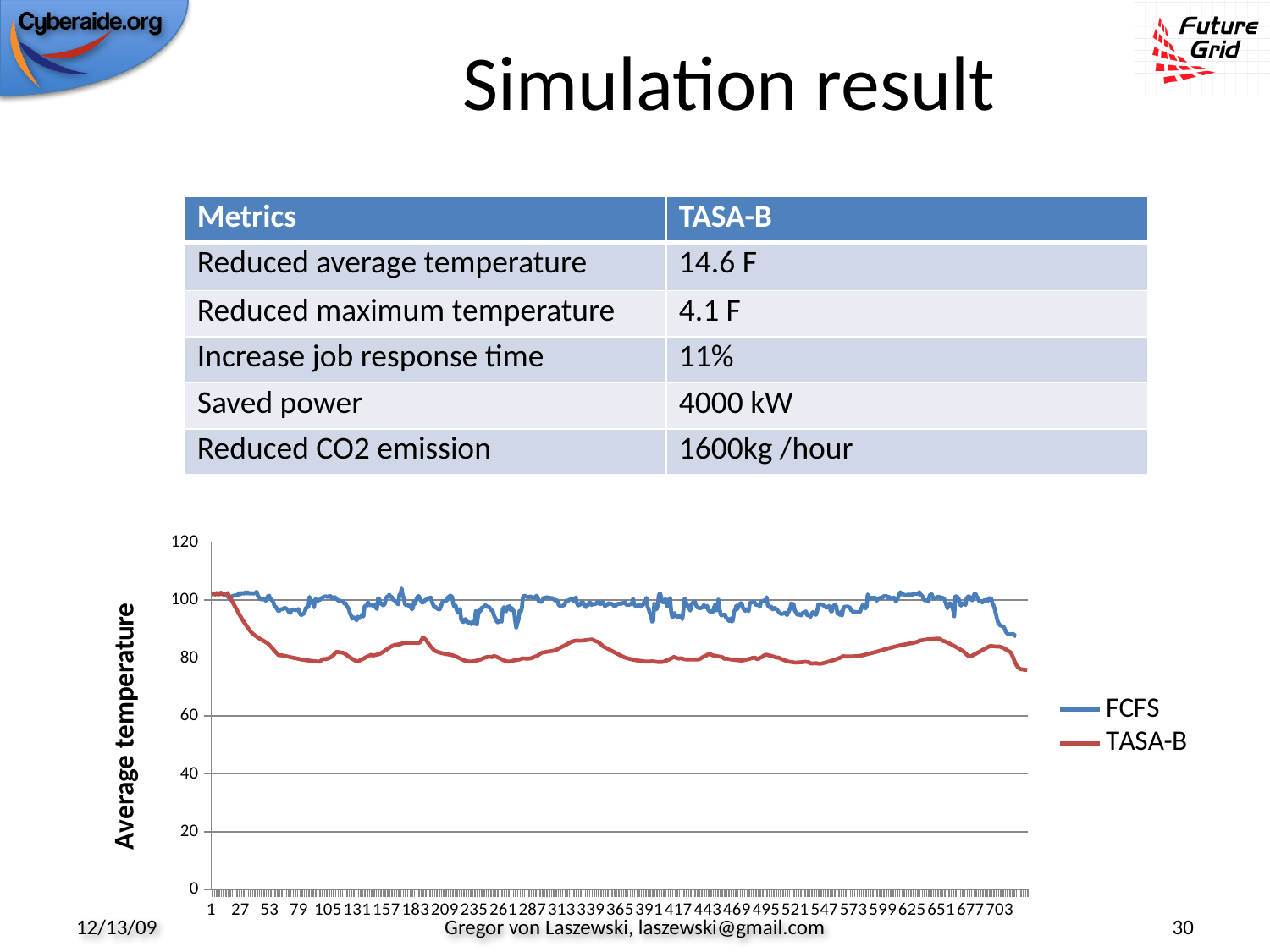
What is the highest value shown on the chart's vertical axis? 120 Which series in the chart has the higher average temperature across the x axis, FCFS or TASA-B? FCFS Are the TASA-B values in the chart mostly greater or less than 100? less Are the FCFS values in the chart greater or less than 120? less What is the label of the chart's vertical axis? Average temperature Are the FCFS values in the chart mostly greater or less than 80? greater What are the two series named in the chart's legend? FCFS and TASA-B What kind of chart is shown at the bottom of the slide? line chart Near the start of the x axis, does the TASA-B line rise or fall? fall How many series does the chart's legend list? 2